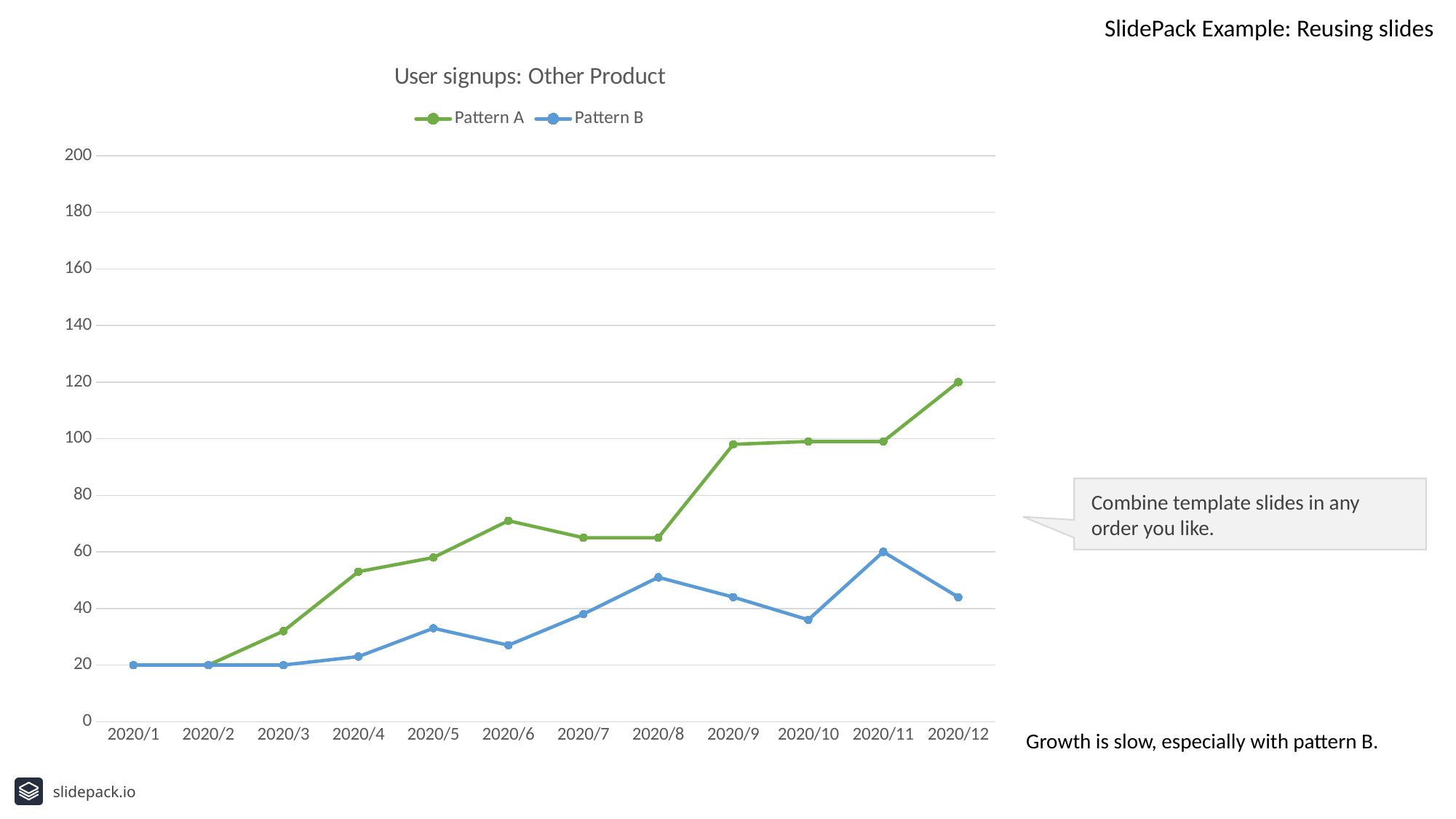
What is the value for Pattern A at 2020/12? 120 Is the value for Pattern A at 2020/9 greater or less than 80? greater How many series does the legend list? 2 What is the title of the chart? User signups: Other Product At which month does Pattern B reach its highest value? 2020/11 At which month does Pattern A reach its highest value? 2020/12 How many points are plotted along the x axis for each series? 12 What is the value for Pattern A at 2020/1? 20 Which series has the larger value at 2020/8, Pattern A or Pattern B? Pattern A What is the value for Pattern B at 2020/11? 60 What type of chart is shown on the slide? line chart Is the value for Pattern B at 2020/10 greater or less than 40? less